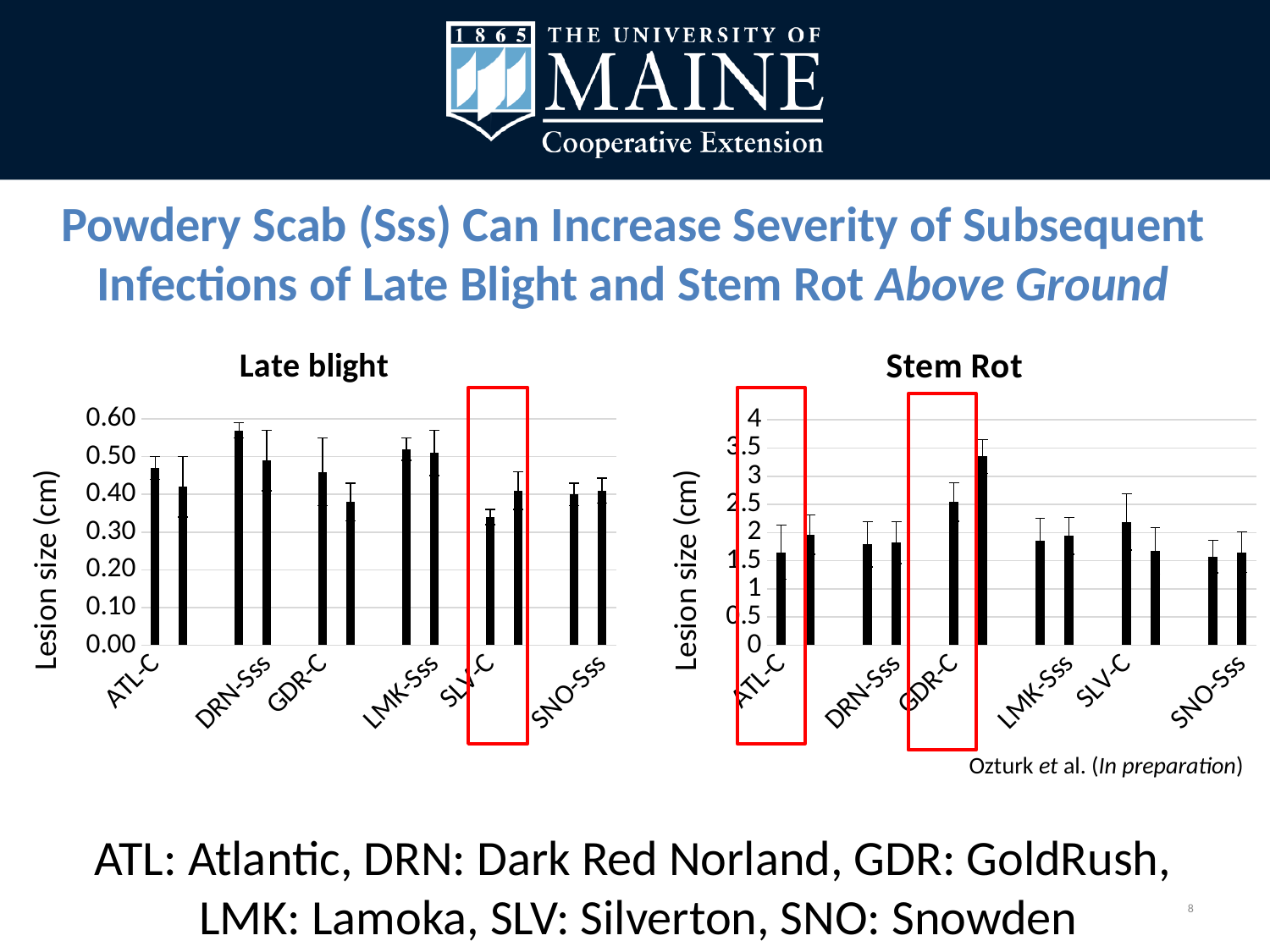
In the Late blight chart, which is larger, the value for LMK-Sss or the value for SLV-C? LMK-Sss In the Stem Rot chart, which is larger, the value for GDR-C or the value for ATL-C? GDR-C In the Late blight chart, is the value for SNO-Sss greater or less than 0.50? less In the Late blight chart, is the value for LMK-Sss greater or less than 0.40? greater How many bars are plotted in the Stem Rot chart? 12 In the Stem Rot chart, is the value for SNO-Sss greater or less than 2? less What kind of chart is the Late blight chart? bar chart What is the y-axis title of the Stem Rot chart? Lesion size (cm)